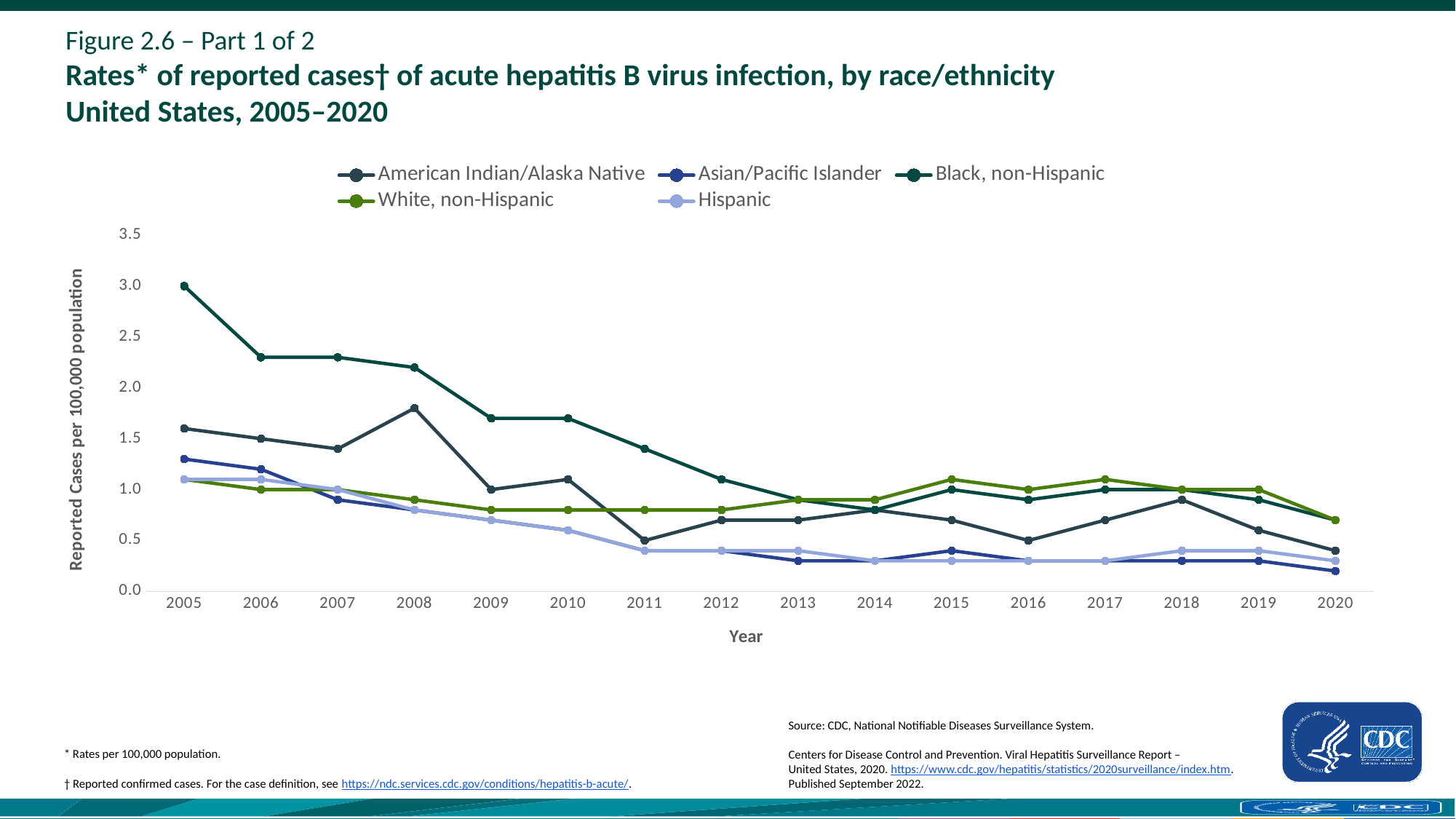
Which race/ethnicity group had the highest rate in 2008? Black, non-Hispanic What kind of chart is shown on the slide? Line chart What is the label on the y axis? Reported Cases per 100,000 population Is the value for Hispanic in 2011 greater or less than 0.5? less In 2011, which is larger: the rate for American Indian/Alaska Native or the rate for Black, non-Hispanic? Black, non-Hispanic Is the value for American Indian/Alaska Native in 2008 greater or less than 1.5? greater Does the rate for Black, non-Hispanic rise or fall from 2005 to 2020? Fall How many years are shown along the x axis? 16 Is the value for Black, non-Hispanic in 2005 greater or less than 2.5? greater How many series does the legend list? 5 Which race/ethnicity group had the highest rate in 2005? Black, non-Hispanic Which race/ethnicity group had the lowest rate in 2020? Asian/Pacific Islander